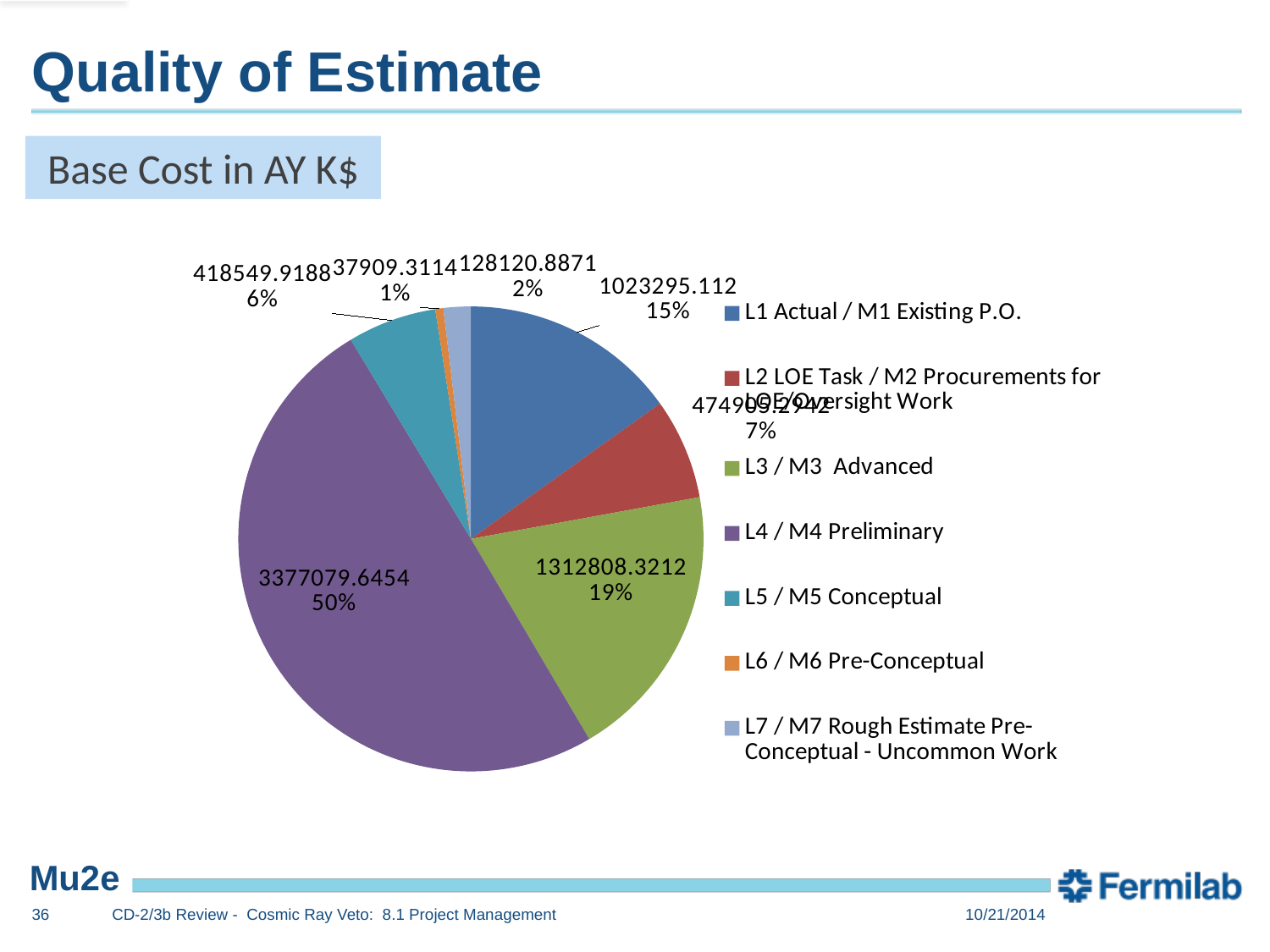
What is the value shown for L4 / M4 Preliminary? 3377079.6454 How many slices does the pie chart have? 7 What kind of chart is shown on the slide? pie chart What is the title shown in the box above the chart? Base Cost in AY K$ What share of the pie does L3 / M3 Advanced represent? 19% Which is larger, the slice for L3 / M3 Advanced or the slice for L1 Actual / M1 Existing P.O.? L3 / M3 Advanced Which category has the largest slice of the pie? L4 / M4 Preliminary How many entries does the legend list? 7 What share of the pie does L4 / M4 Preliminary represent? 50% What is the value shown for L1 Actual / M1 Existing P.O.? 1023295.112 What is the value shown for L5 / M5 Conceptual? 418549.9188 Which category has the smallest slice of the pie? L6 / M6 Pre-Conceptual